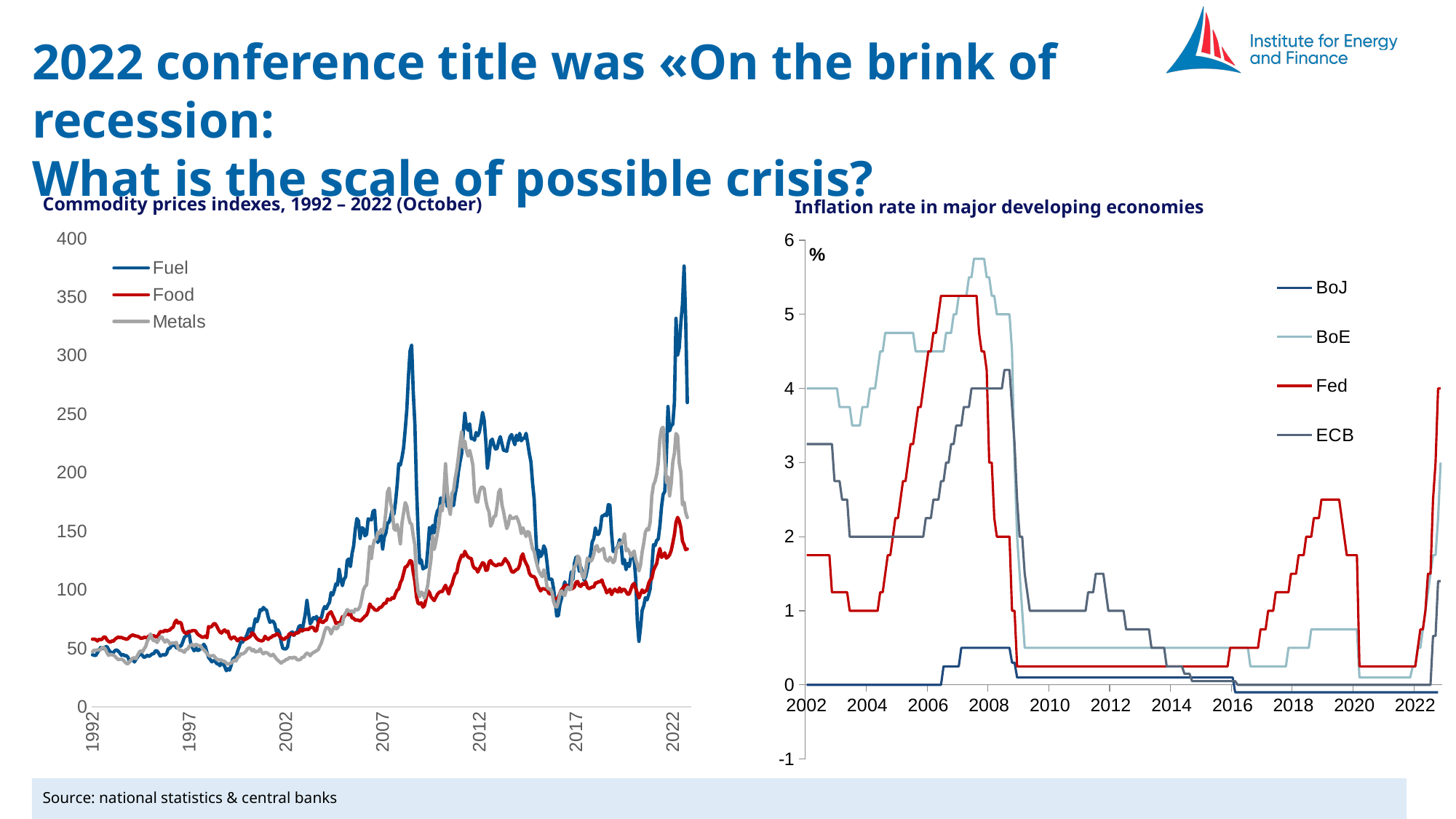
What kind of chart is the 'Commodity prices indexes, 1992 – 2022 (October)' chart? line chart In the 'Commodity prices indexes' chart, is the 2022 peak of the Fuel index greater or less than 350? greater How many series does the legend of the 'Inflation rate in major developing economies' chart list? 4 In the 'Commodity prices indexes' chart, which series reaches the highest peak? Fuel How many series does the legend of the 'Commodity prices indexes' chart list? 3 What kind of chart is the 'Inflation rate in major developing economies' chart? line chart In the 'Inflation rate in major developing economies' chart, is the highest value for BoJ greater or less than 1? less In the 'Commodity prices indexes' chart, at the 2008 peak, which is higher: Fuel or Food? Fuel In the 'Inflation rate in major developing economies' chart, which series stays lowest across the whole period? BoJ In the 'Inflation rate in major developing economies' chart, is the Fed value at the end of 2022 greater or less than 3? greater In the 'Commodity prices indexes' chart, does the Food index overall rise or fall from 1992 to 2022? rise